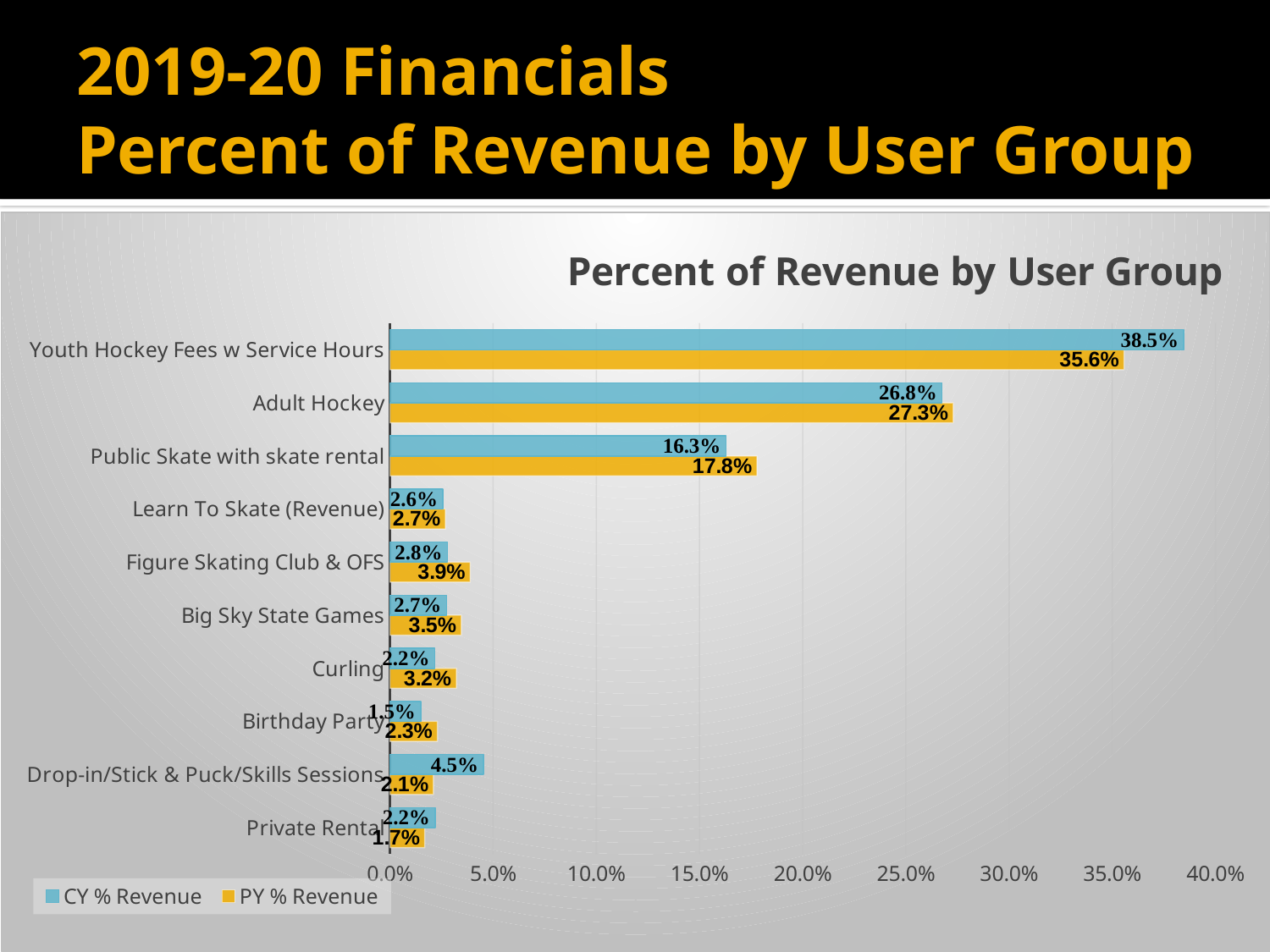
What is the CY % Revenue for Drop-in/Stick & Puck/Skills Sessions? 4.5% What kind of chart is shown on the slide? Bar chart Is the CY % Revenue for Adult Hockey greater or less than 25.0%? greater How many series does the legend list? 2 What is the CY % Revenue for Youth Hockey Fees w Service Hours? 38.5% Which is larger for Curling: CY % Revenue or PY % Revenue? PY % Revenue What is the PY % Revenue for Adult Hockey? 27.3% How many user groups are shown on the chart? 10 Which user group has the highest CY % Revenue? Youth Hockey Fees w Service Hours Which user group has the lowest PY % Revenue? Private Rental What is the difference between the CY % Revenue and PY % Revenue for Youth Hockey Fees w Service Hours? 2.9% What is the PY % Revenue for Public Skate with skate rental? 17.8%